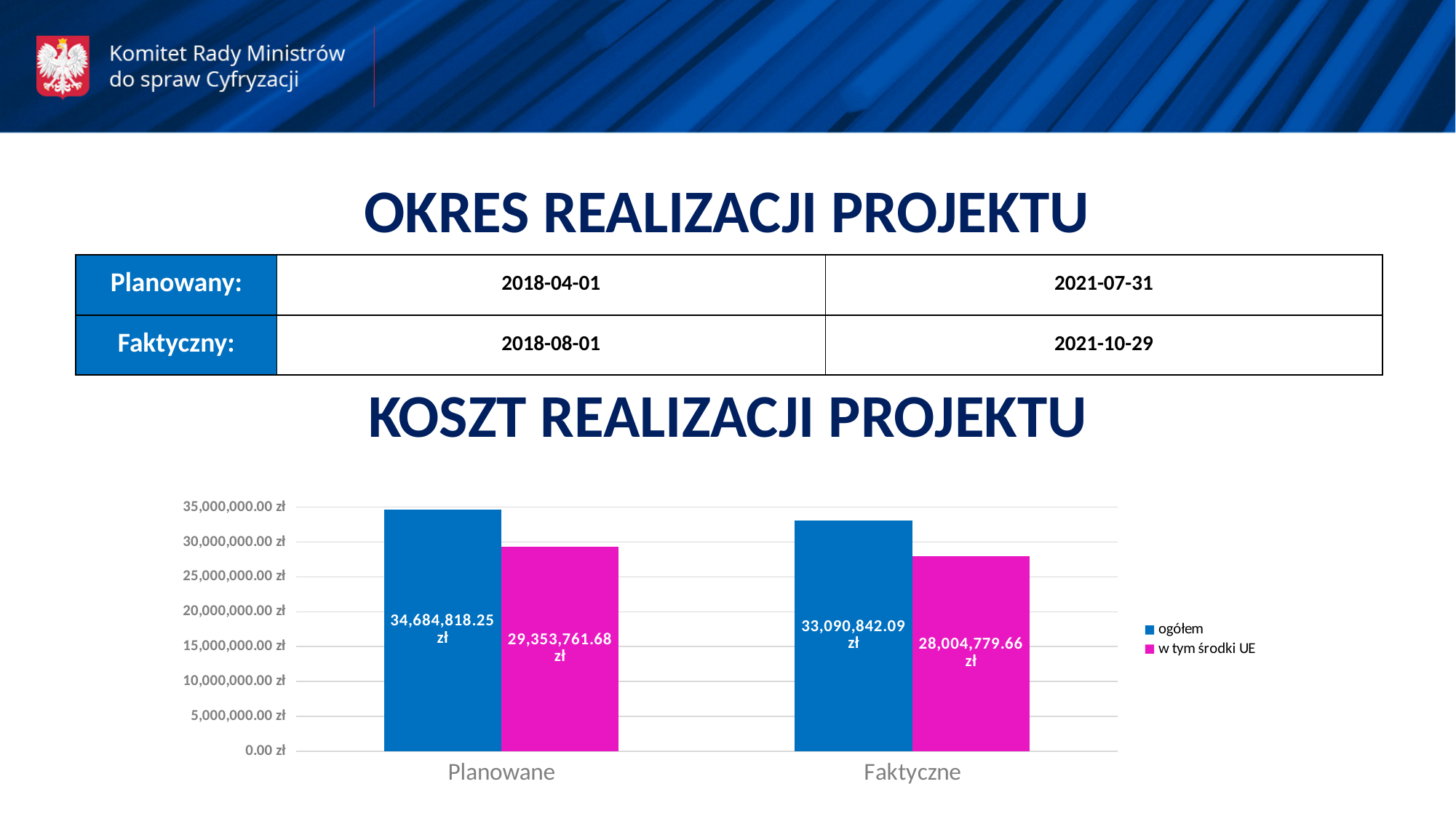
How many series does the legend list? 2 What is the value of w tym środki UE for Planowane? 29,353,761.68 zł What is the value of ogółem for Planowane? 34,684,818.25 zł What is the difference between ogółem and w tym środki UE for Faktyczne? 5,086,062.43 zł What is the value of ogółem for Faktyczne? 33,090,842.09 zł What is the difference between ogółem for Planowane and ogółem for Faktyczne? 1,593,976.16 zł Which bar in the chart has the highest value? ogółem for Planowane Which bar in the chart has the lowest value? w tym środki UE for Faktyczne Which is larger: w tym środki UE for Planowane or w tym środki UE for Faktyczne? w tym środki UE for Planowane What kind of chart is shown under the title KOSZT REALIZACJI PROJEKTU? bar chart How many categories are shown on the x axis of the chart? 2 What is the value of w tym środki UE for Faktyczne? 28,004,779.66 zł